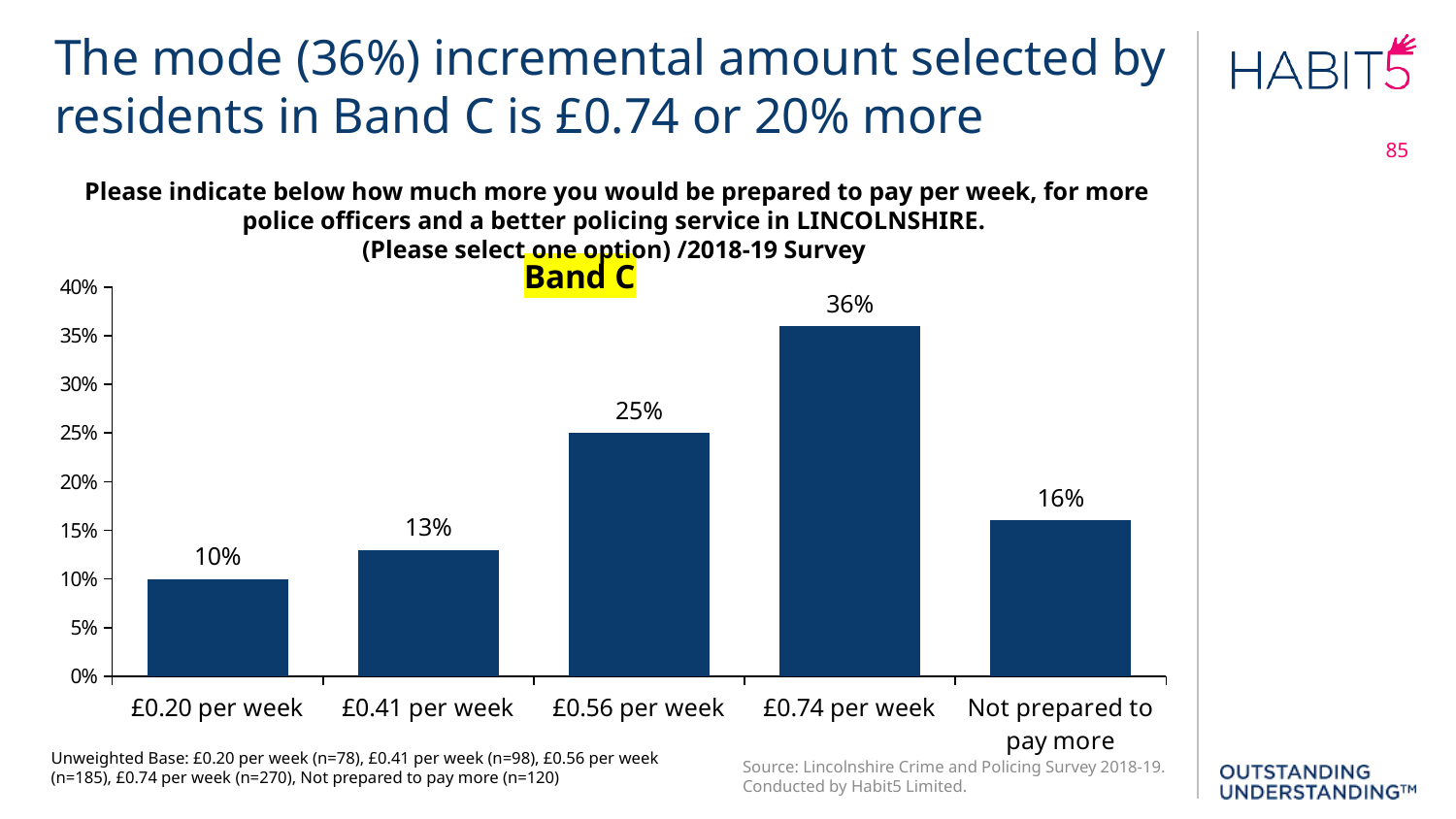
Which option has the lowest percentage in the chart? £0.20 per week What is the difference in percentage points between £0.74 per week and £0.56 per week? 11 What kind of chart is shown on the slide? Bar chart Is the value for £0.41 per week greater or less than 15%? less What percentage of Band C residents were not prepared to pay more? 16% Which option has the highest percentage in the chart? £0.74 per week How many categories are shown on the x axis of the chart? 5 What percentage of Band C residents selected £0.20 per week? 10% Which band is the chart about, as shown in the highlighted label above the chart? Band C What percentage of Band C residents selected £0.74 per week? 36% Which is larger: the percentage for £0.56 per week or for Not prepared to pay more? £0.56 per week What is the difference in percentage points between £0.41 per week and £0.20 per week? 3